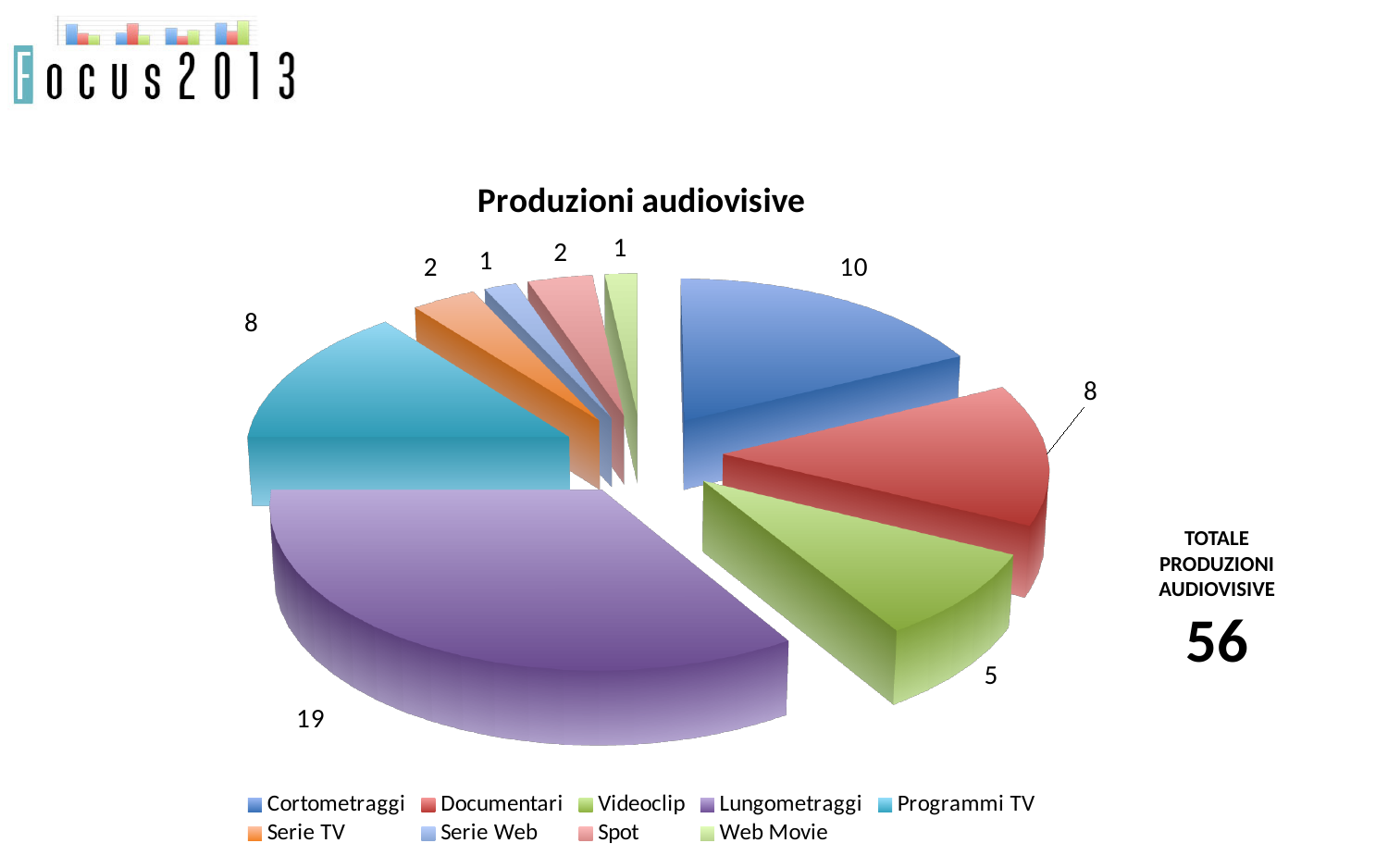
Which is larger, the value for Documentari or the value for Videoclip? Documentari What is the total of all the slices, as stated on the slide? 56 What is the value for Programmi TV? 8 What is the difference between the values for Lungometraggi and Cortometraggi? 9 What is the value for Cortometraggi? 10 What type of chart is shown on the slide? pie chart What is the difference between the values for Serie TV and Serie Web? 1 What is the title of the chart? Produzioni audiovisive How many categories does the pie chart have? 9 What is the value for Lungometraggi? 19 Which category has the largest slice? Lungometraggi What is the value for Videoclip? 5